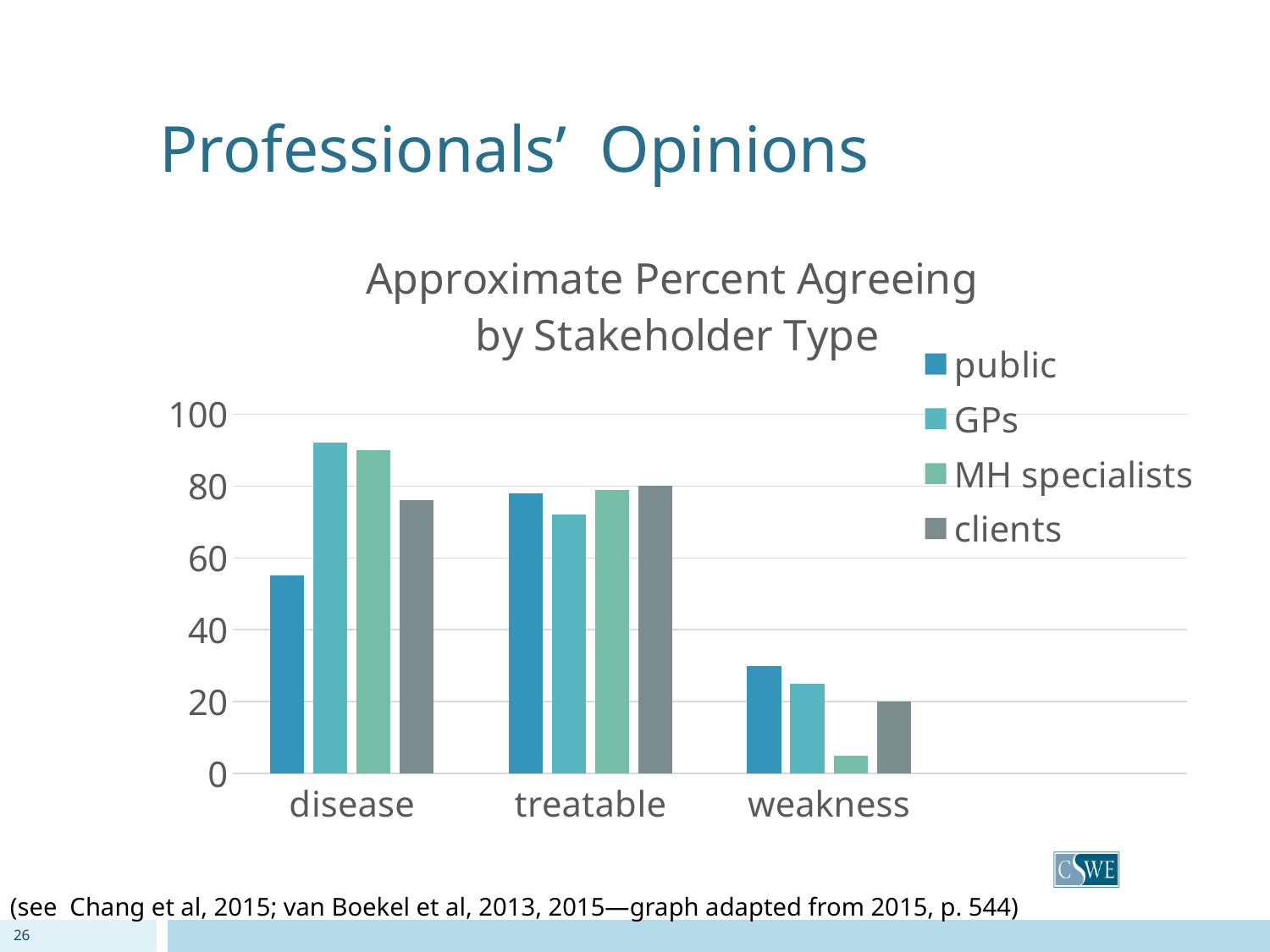
What kind of chart is shown on the slide? bar chart Is the value for 'GPs' in the 'disease' category greater or less than 80? greater For the 'public' series, which is larger: the value for 'disease' or the value for 'treatable'? treatable Which stakeholder group has the lowest value for 'disease'? public What is the title of the chart? Approximate Percent Agreeing by Stakeholder Type Which stakeholder group has the lowest value for 'weakness'? MH specialists How many categories are shown on the x axis? 3 Which stakeholder group has the highest value for 'weakness'? public Is the value for 'clients' in the 'disease' category greater or less than 60? greater Is the value for 'public' in the 'disease' category greater or less than 60? less How many series does the legend list? 4